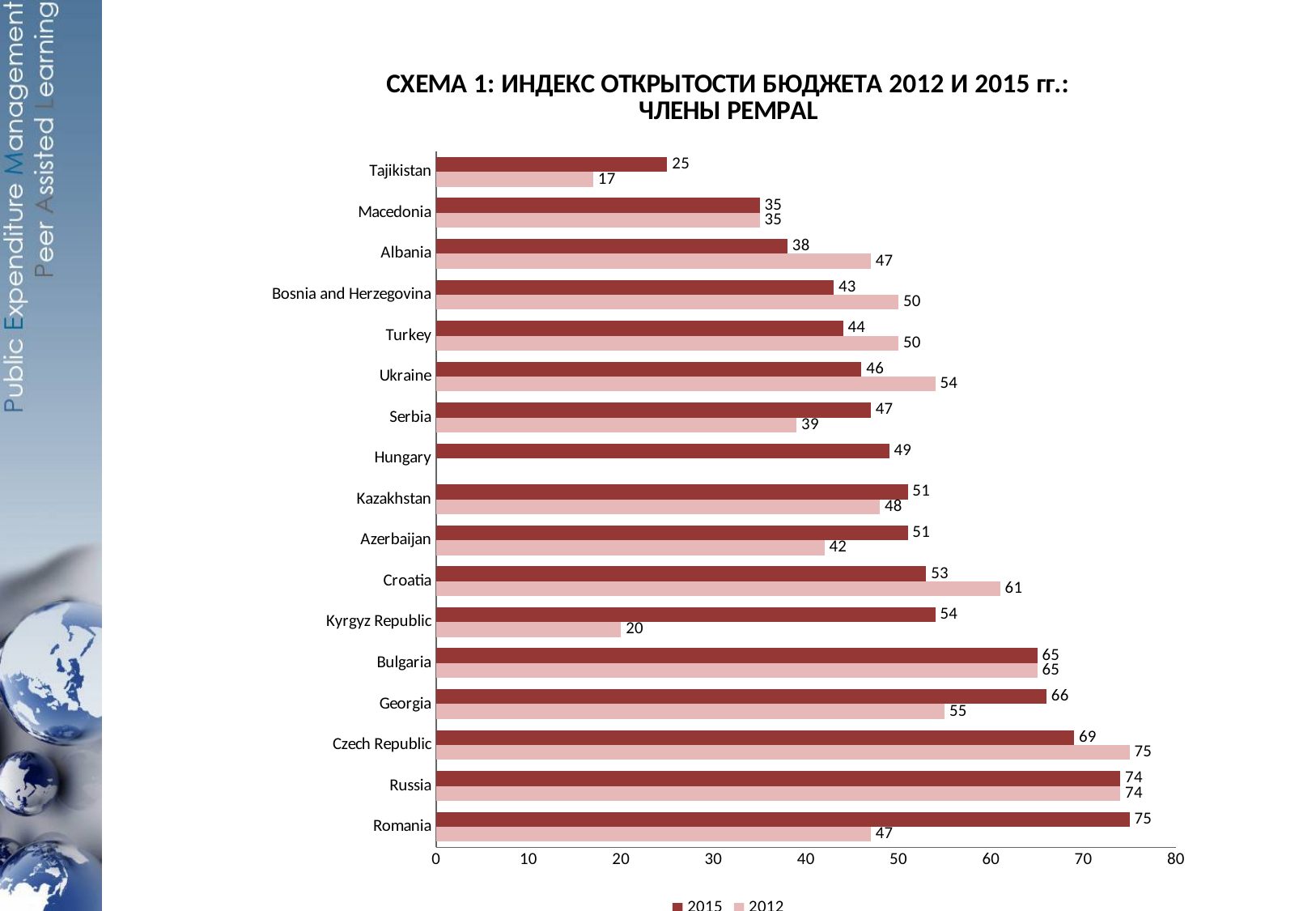
Which is larger for Croatia, the 2012 value or the 2015 value? 2012 Is the 2015 value for Ukraine greater or less than 40? greater Which country has no 2012 bar shown? Hungary What is the 2012 value for Kyrgyz Republic? 20 How many series does the legend list? 2 Which country has the same value in 2012 and 2015 at 74? Russia What kind of chart is shown on the slide? Bar chart Which country has the highest 2015 value? Romania What is the difference between the 2012 and 2015 values for Czech Republic? 6 Which country has the lowest 2012 value? Tajikistan How many countries are shown on the chart? 17 What is the 2015 value for Georgia? 66